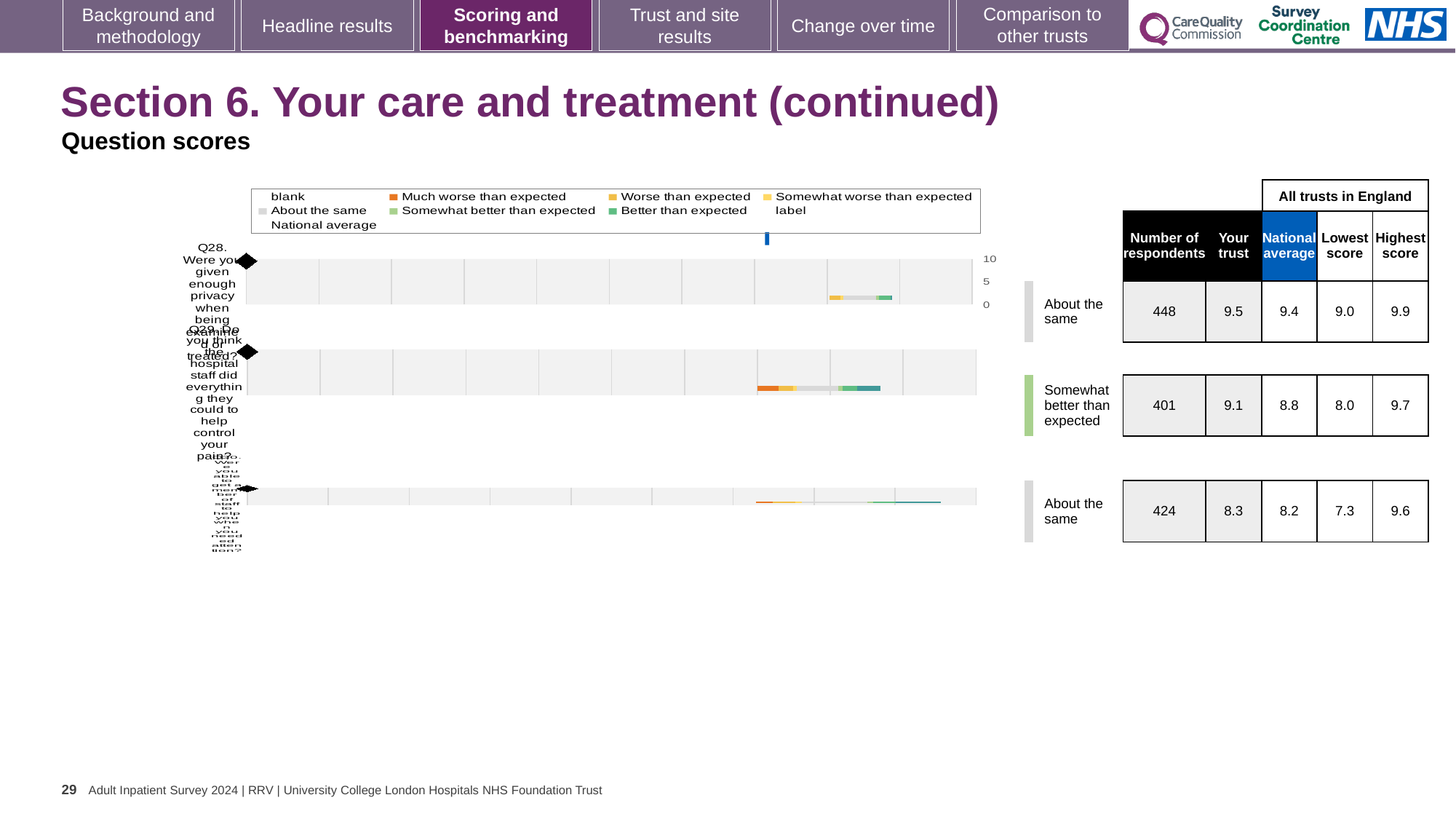
What kind of chart is shown on the slide? bar chart What is the lowest score among all trusts in England for Q30? 7.3 How many survey questions (rows) are plotted in the chart? 3 Which question has the highest 'Your trust' score? Q28 What benchmark category is shown for Q29? Somewhat better than expected What is the 'Your trust' score for Q28 (privacy when being examined or treated)? 9.5 What is the difference between the 'Your trust' score and the national average for Q29? 0.3 What is the national average score for Q29 (staff did everything to help control pain)? 8.8 How many respondents answered Q30 (able to get a member of staff to help when needed)? 424 What is the highest score among all trusts in England for Q28? 9.9 Which question has the lowest 'Your trust' score? Q30 For Q30, which is larger: the 'Your trust' score or the national average? Your trust